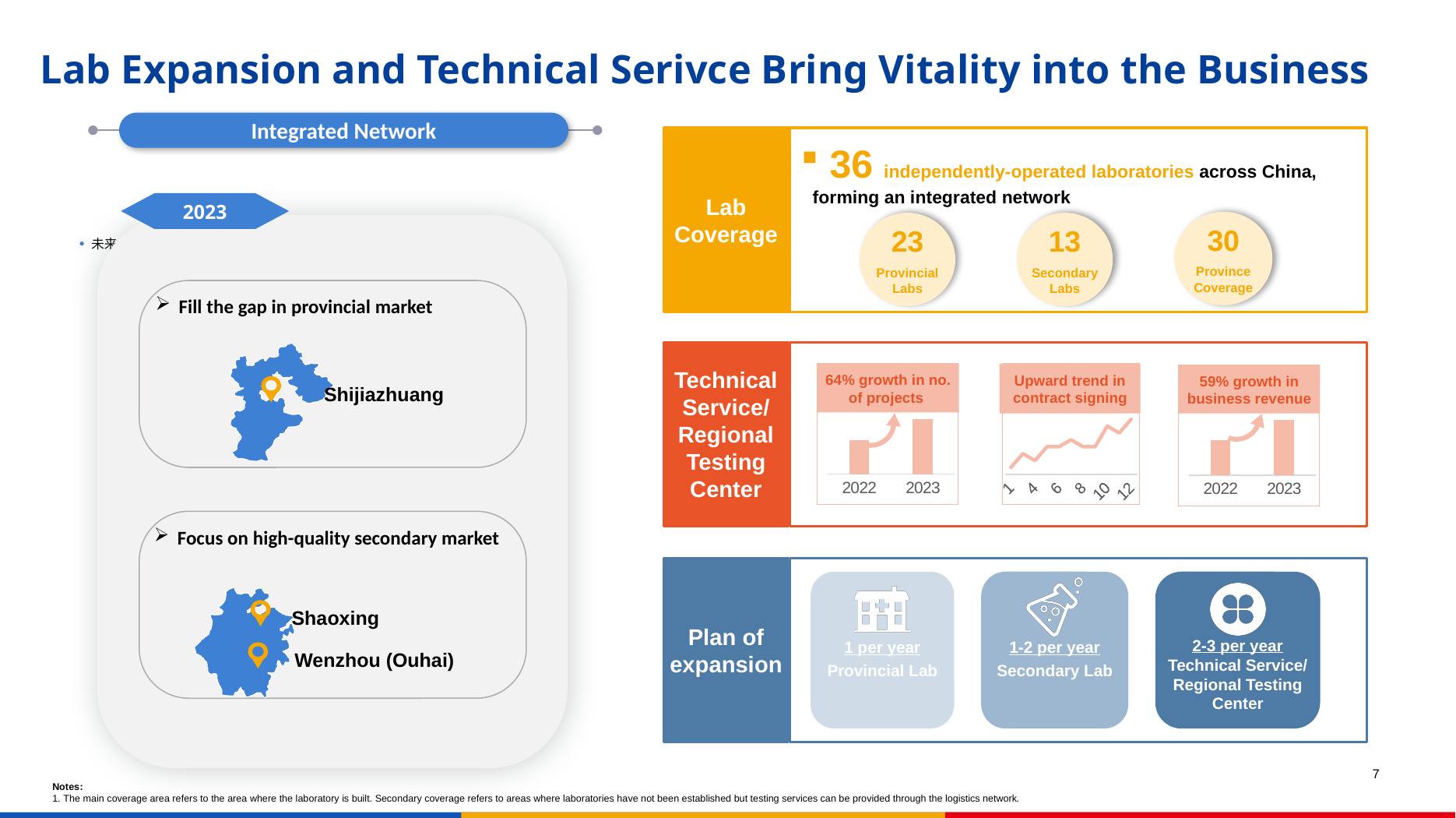
In the '59% growth in business revenue' chart, which years are shown on the x axis? 2022 and 2023 In the '64% growth in no. of projects' chart, what kind of chart is shown? bar chart In the '59% growth in business revenue' chart, which year has the taller bar, 2022 or 2023? 2023 In the 'Upward trend in contract signing' chart, what is the last tick label on the x axis? 12 In the 'Upward trend in contract signing' chart, do the values generally rise or fall along the x axis? rise In the '59% growth in business revenue' chart, do the values rise or fall from 2022 to 2023? rise In the 'Upward trend in contract signing' chart, what kind of chart is shown? line chart In the '64% growth in no. of projects' chart, which year has the lowest bar? 2022 In the '64% growth in no. of projects' chart, which year has the taller bar, 2022 or 2023? 2023 In the '59% growth in business revenue' chart, what kind of chart is shown? bar chart In the '64% growth in no. of projects' chart, how many years are shown on the x axis? 2 In the '59% growth in business revenue' chart, which year has the highest bar? 2023